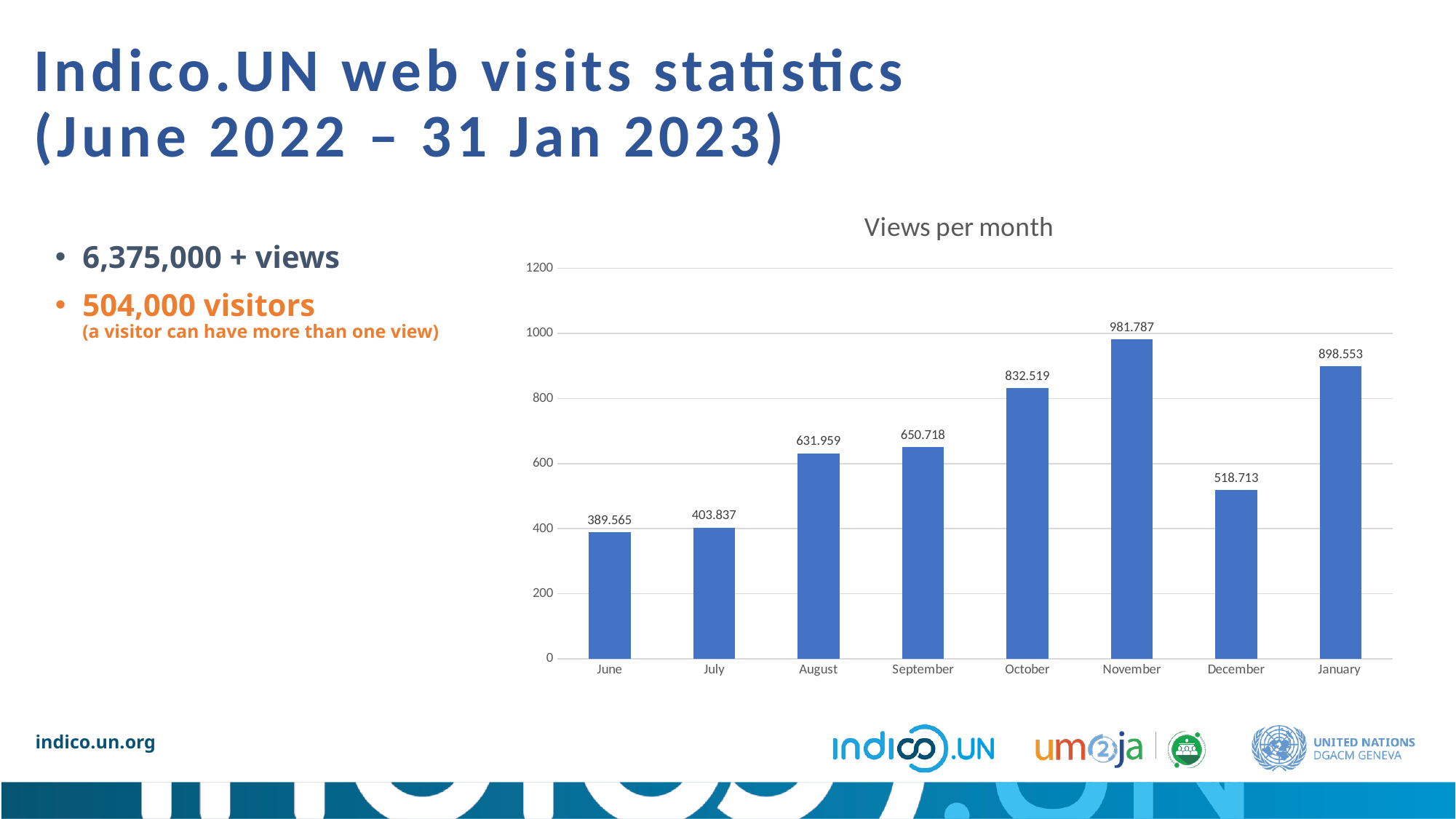
What is the difference between the values for November and December in the Views per month chart? 463.074 What kind of chart is the Views per month chart? bar chart What is the value for November in the Views per month chart? 981.787 What is the title of the chart on the slide? Views per month What is the value for June in the Views per month chart? 389.565 Is the value for August in the Views per month chart greater or less than 600? greater What is the difference between the values for October and September in the Views per month chart? 181.801 How many months are shown in the Views per month chart? 8 Which is larger in the Views per month chart, the value for January or the value for October? January What is the value for December in the Views per month chart? 518.713 Which month has the highest value in the Views per month chart? November Which month has the lowest value in the Views per month chart? June